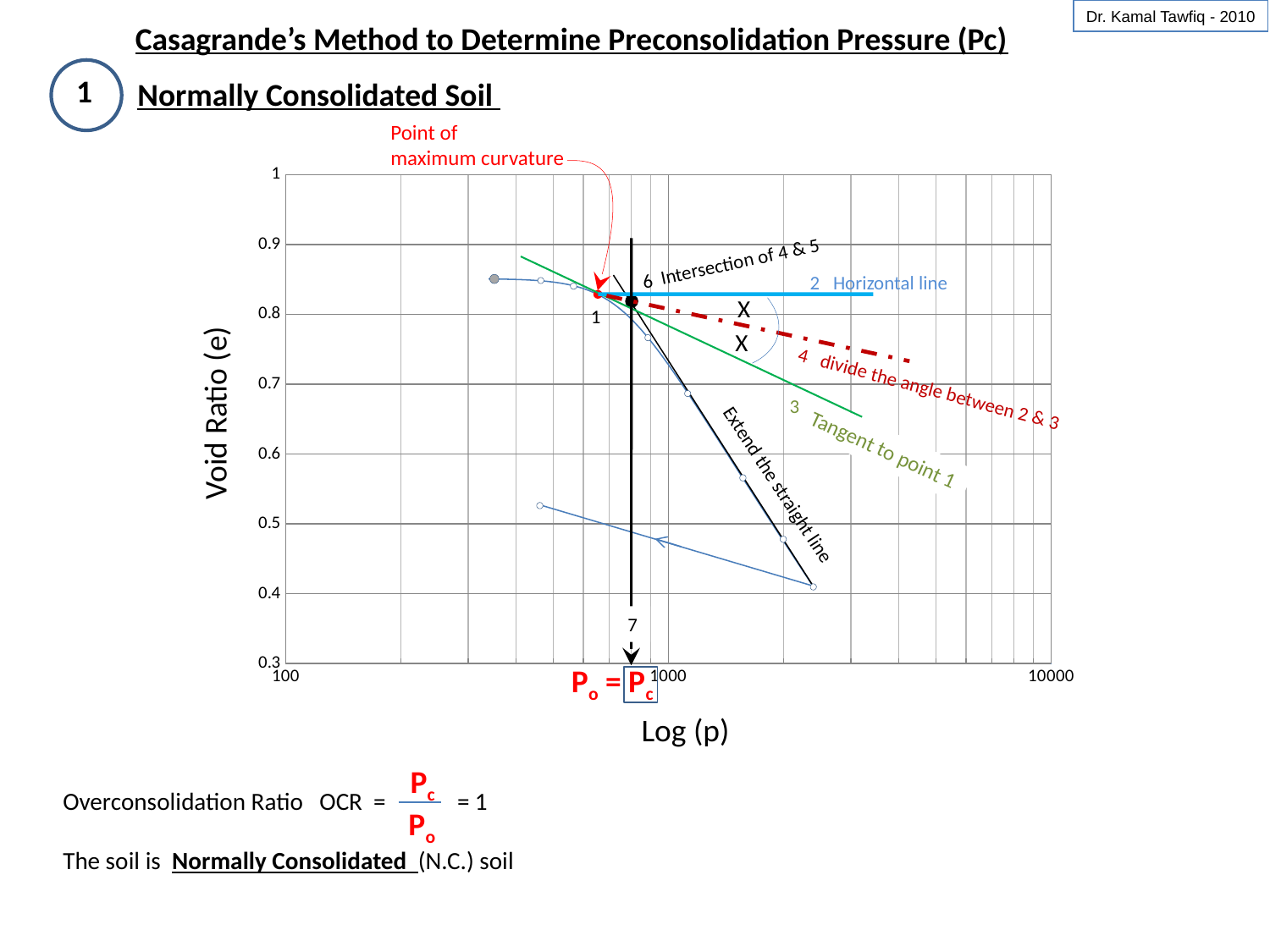
Which has the larger void ratio: the leftmost point of the loading curve or the rightmost point of the loading curve? the leftmost point Is the void ratio of the leftmost point on the loading curve greater or less than 0.8? greater What kind of chart is shown on the slide? line chart At which end of the loading curve is the void ratio highest, the low-pressure (left) end or the high-pressure (right) end? the low-pressure (left) end Is the void ratio at point 1 (the point of maximum curvature) greater or less than 0.7? greater Is the void ratio of the left end of the unloading (rebound) curve greater or less than 0.6? less What is the label of the vertical axis of the chart? Void Ratio (e) Along the loading curve, does the void ratio rise or fall as Log (p) increases? fall What is the label of the horizontal axis of the chart? Log (p)